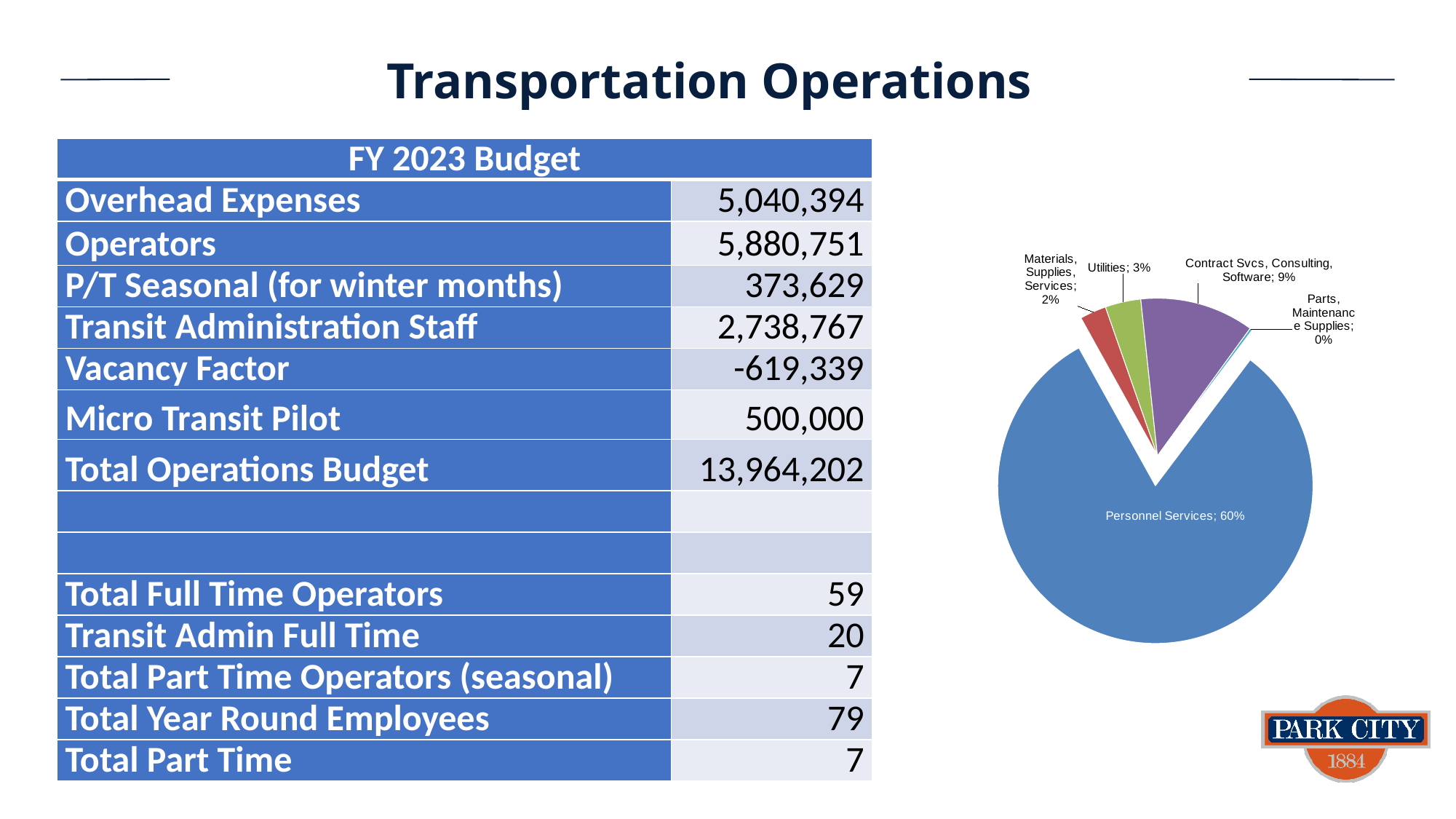
In the pie chart, what is the difference in percentage points between Contract Svcs, Consulting, Software and Utilities? 6 In the pie chart, what share is labelled for Utilities? 3% How many slices are labelled in the pie chart? 5 In the pie chart, what share is labelled for Personnel Services? 60% In the pie chart, what share is labelled for Materials, Supplies, Services? 2% In the pie chart, which is larger: Utilities or Materials, Supplies, Services? Utilities Which slice of the pie chart is the largest? Personnel Services What colour is the Personnel Services slice in the pie chart? blue Which slice of the pie chart is the smallest? Parts, Maintenance Supplies What kind of chart is shown on the right of the slide? pie chart